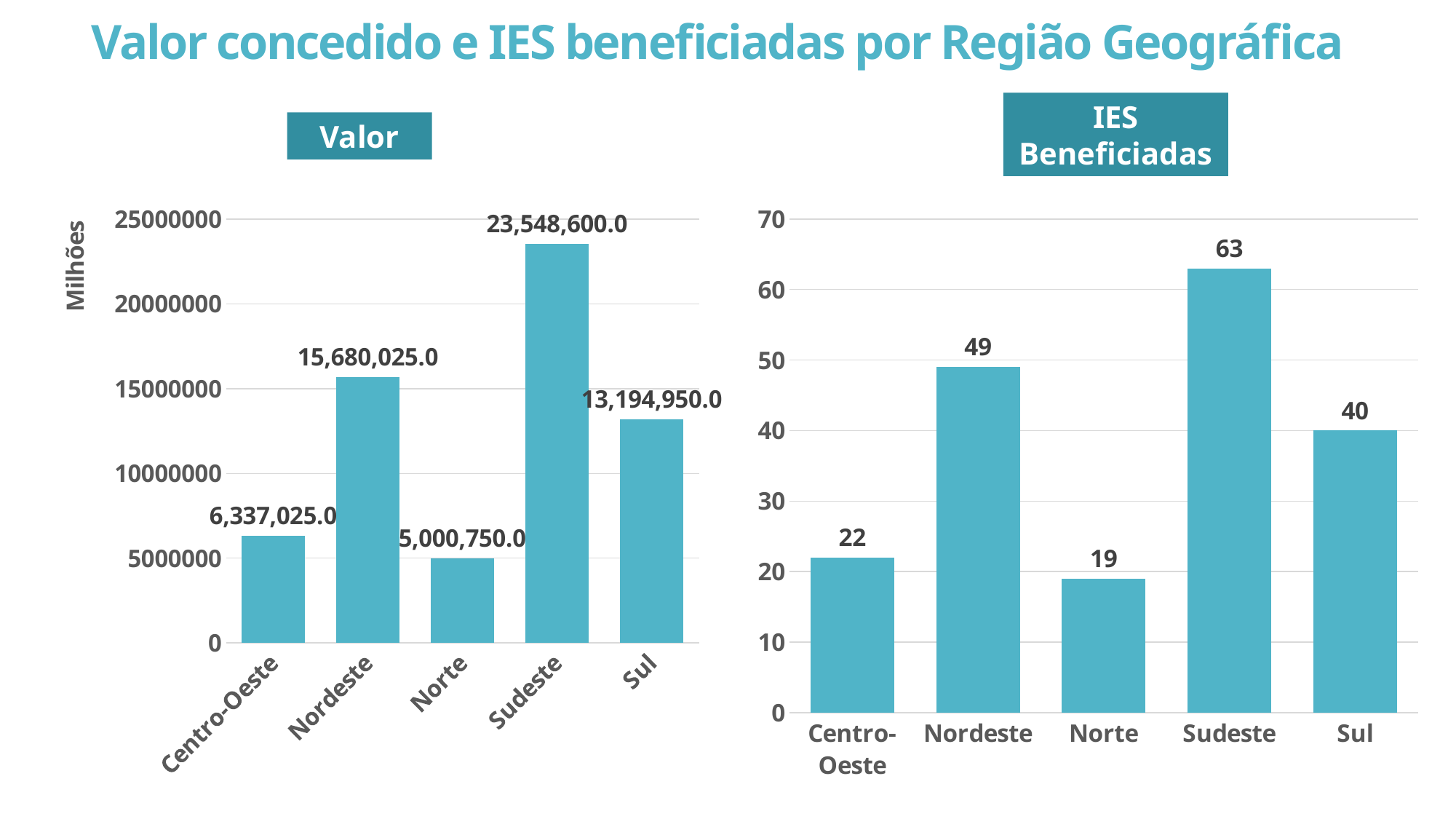
How many regions are shown in the 'IES Beneficiadas' chart? 5 In the 'IES Beneficiadas' chart, which region has the highest number? Sudeste In the 'Valor' chart, what is the difference between Nordeste and Sul? 2,485,075.0 What type of chart is the 'Valor' chart? Bar chart In the 'IES Beneficiadas' chart, which is larger, Centro-Oeste or Norte? Centro-Oeste In the 'Valor' chart, what is the value for Norte? 5,000,750.0 In the 'Valor' chart, is the value for Centro-Oeste greater or less than 5000000? greater In the 'Valor' chart, which region has the lowest value? Norte In the 'IES Beneficiadas' chart, which region has the lowest number? Norte In the 'IES Beneficiadas' chart, what is the difference between Sudeste and Sul? 23 In the 'Valor' chart, what is the value for Sudeste? 23,548,600.0 In the 'IES Beneficiadas' chart, how many IES were benefited in Nordeste? 49